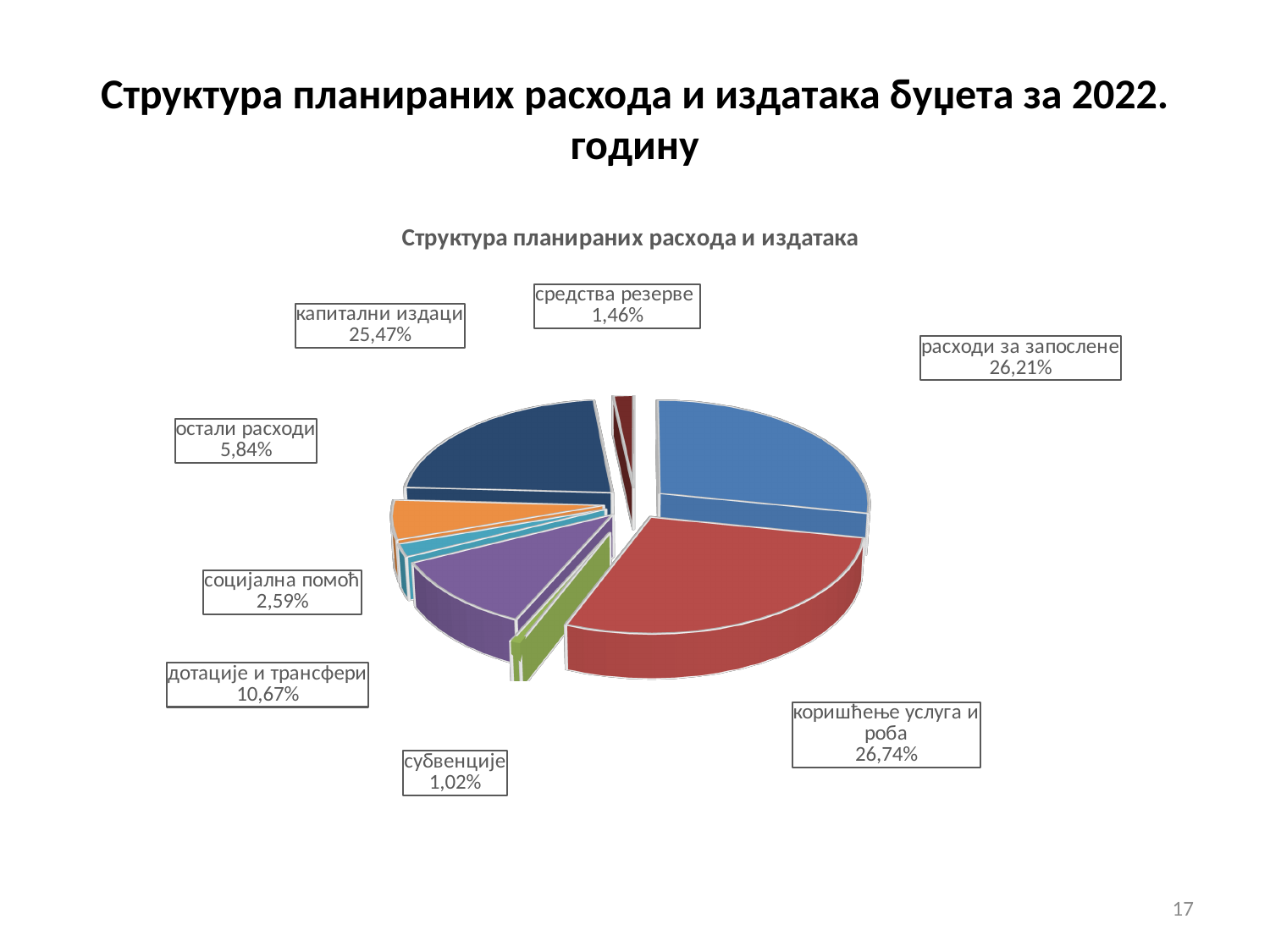
What percentage is shown for социјална помоћ? 2,59% What percentage is shown for капитални издаци? 25,47% What is the difference in percentage points between капитални издаци and дотације и трансфери? 14,80 What percentage is shown for дотације и трансфери? 10,67% What share of the pie is labelled for коришћење услуга и роба? 26,74% Which category has the largest share of the pie? коришћење услуга и роба How many categories (slices) does the pie chart have? 8 Which is larger: the share for расходи за запослене or the share for капитални издаци? расходи за запослене Which category has the smallest share of the pie? субвенције What is the difference in percentage points between коришћење услуга и роба and расходи за запослене? 0,53 What type of chart is shown on the slide? pie chart What is the title of the chart? Структура планираних расхода и издатака